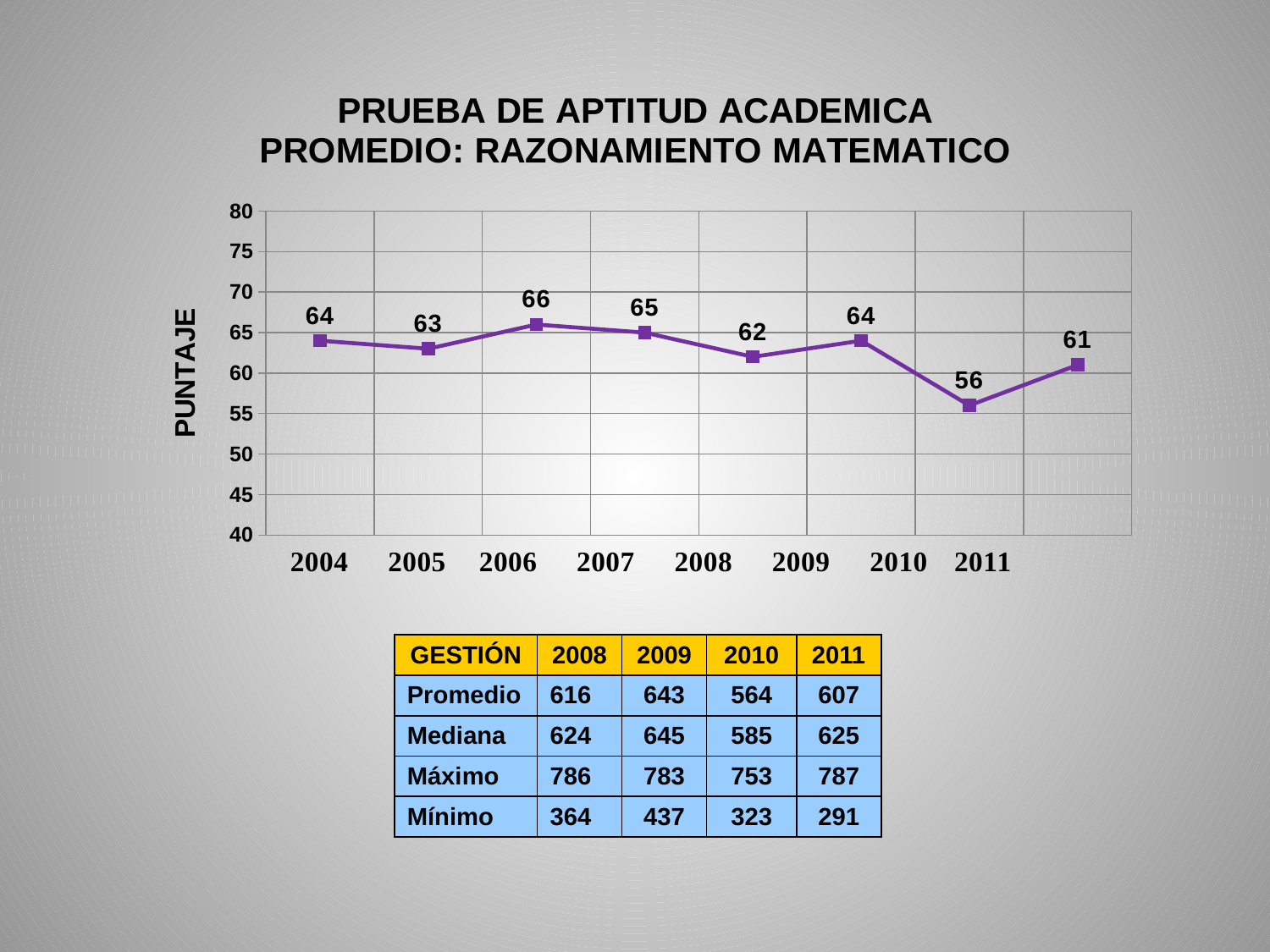
Which is larger, the value for 2007 or the value for 2008? 2007 Is the value for 2010 greater or less than 60? less What is the label on the vertical axis? PUNTAJE What is the value for 2010? 56 What is the value for 2006? 66 How many years are plotted on the chart? 8 What is the difference between the values for 2006 and 2010? 10 What is the value for 2011? 61 Which year has the highest value? 2006 Does the value rise or fall from 2009 to 2010? fall Which year has the lowest value? 2010 What kind of chart is shown? line chart